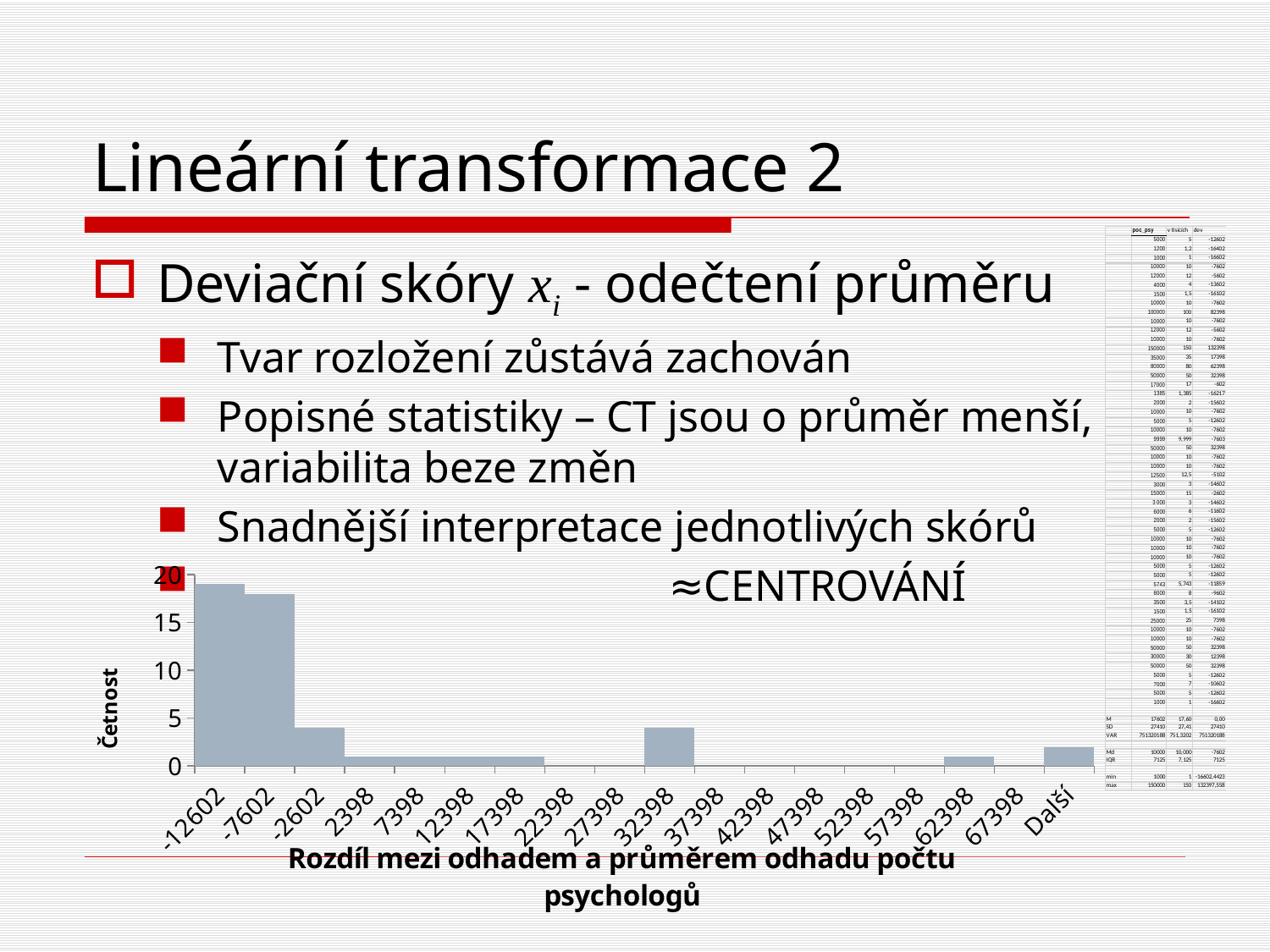
What is the title of the y axis of the chart? Četnost What kind of chart is shown on the slide? bar chart Which is larger, the value for -12602 or the value for 32398? -12602 What is the frequency for the category 22398? 0 What is the title of the x axis of the chart? Rozdíl mezi odhadem a průměrem odhadu počtu psychologů Is the value for -12602 greater or less than 15? greater Do the values rise or fall from -12602 to -2602 along the x axis? fall How many categories are shown on the x axis of the chart? 18 Which category has the highest frequency (Četnost) in the chart? -12602 Is the value for -7602 greater or less than 15? greater Is the value for 32398 greater or less than 5? less